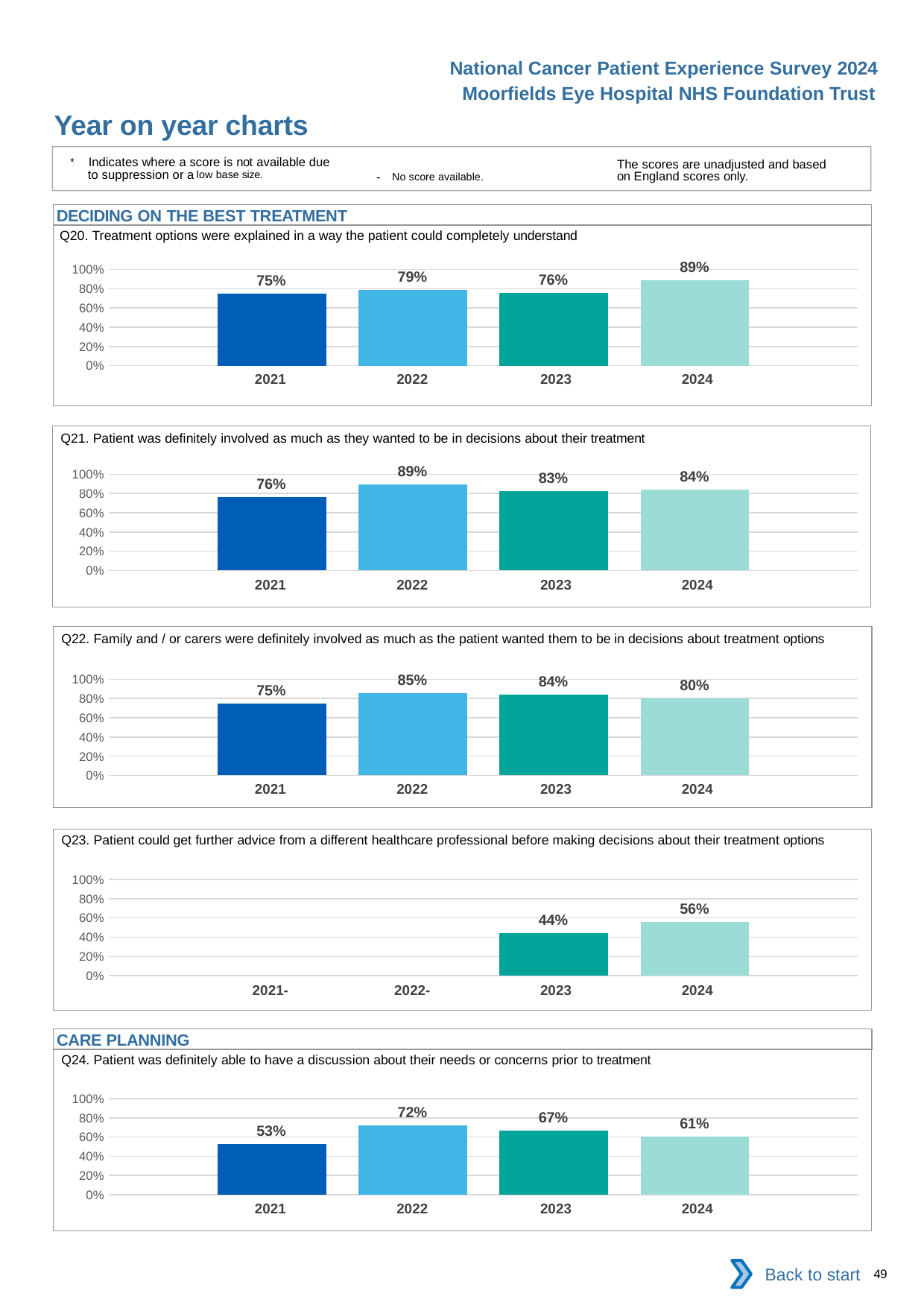
In the Q24 chart, do the values rise or fall from 2022 to 2024? fall In the Q24 chart, is the value for 2022 greater or less than 60%? greater In the Q21 chart, what is the difference between the 2022 and 2021 values? 13% In the Q22 chart, which is larger, the value for 2022 or the value for 2024? 2022 In the Q22 chart, what is the value for 2023? 84% In the Q20 chart, what is the value for 2024? 89% In the Q20 chart, which year has the lowest value? 2021 In the Q24 chart, what is the value for 2021? 53% In the Q23 chart, what is the value for 2023? 44% In the Q21 chart, which year has the highest value? 2022 In the Q23 chart, how many years have a bar plotted? 2 What kind of chart is used for Q20? bar chart